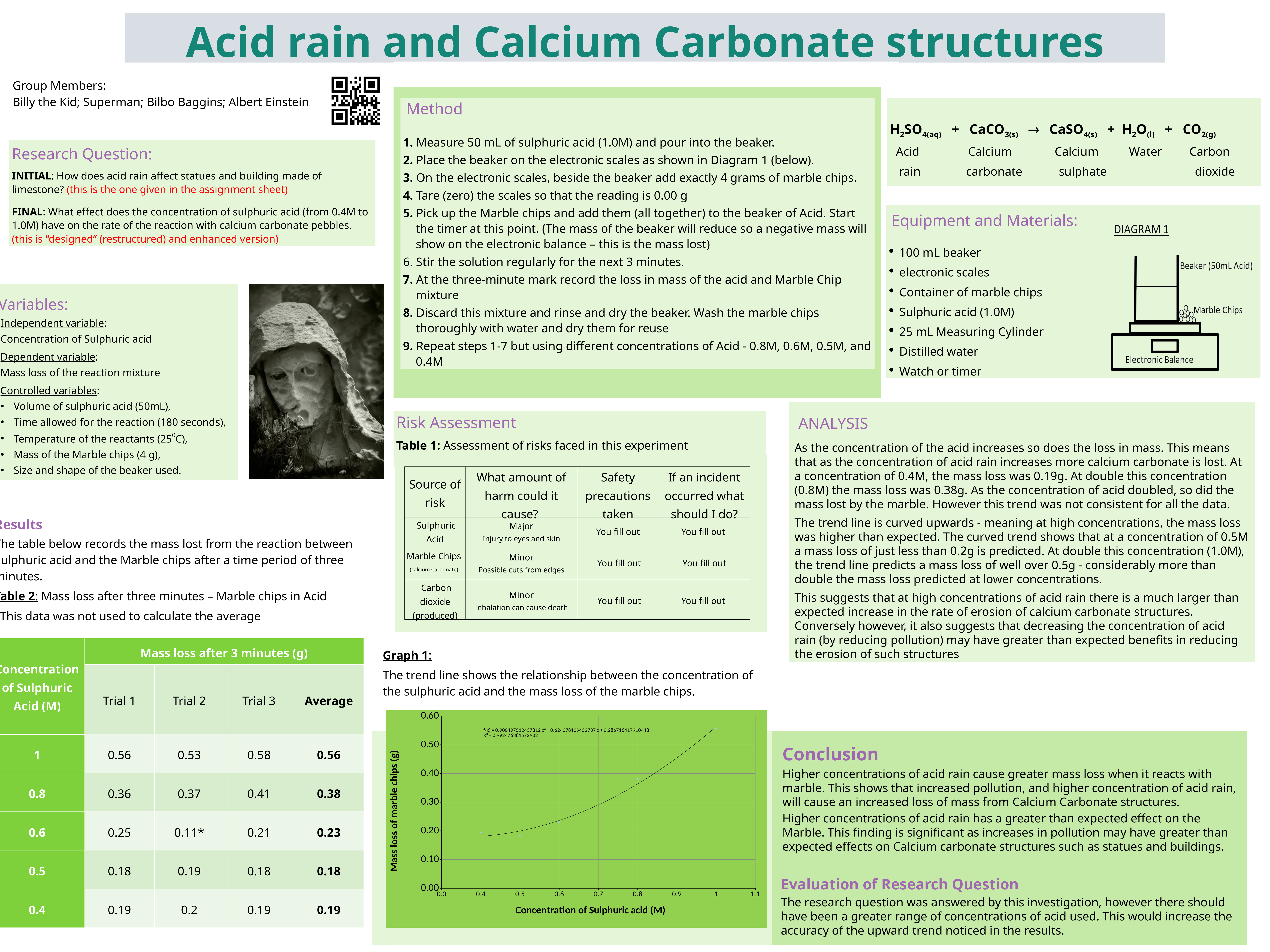
In Graph 1, which has the larger mass loss: a concentration of 0.8 M or 0.6 M? 0.8 In Graph 1, is the mass loss at a concentration of 0.4 M greater or less than 0.30 g? less In Graph 1, is the mass loss at a concentration of 0.5 M greater or less than 0.30 g? less In Graph 1, at which concentration of sulphuric acid is the mass loss highest? 1 How many data points are plotted in Graph 1? 5 What kind of chart is Graph 1? scatter chart In Graph 1, is the mass loss at a concentration of 0.8 M greater or less than 0.30 g? greater What is the y-axis title of Graph 1? Mass loss of marble chips (g) In Graph 1, does the mass loss rise or fall as the concentration of sulphuric acid increases? rise What is the x-axis title of Graph 1? Concentration of Sulphuric acid (M)